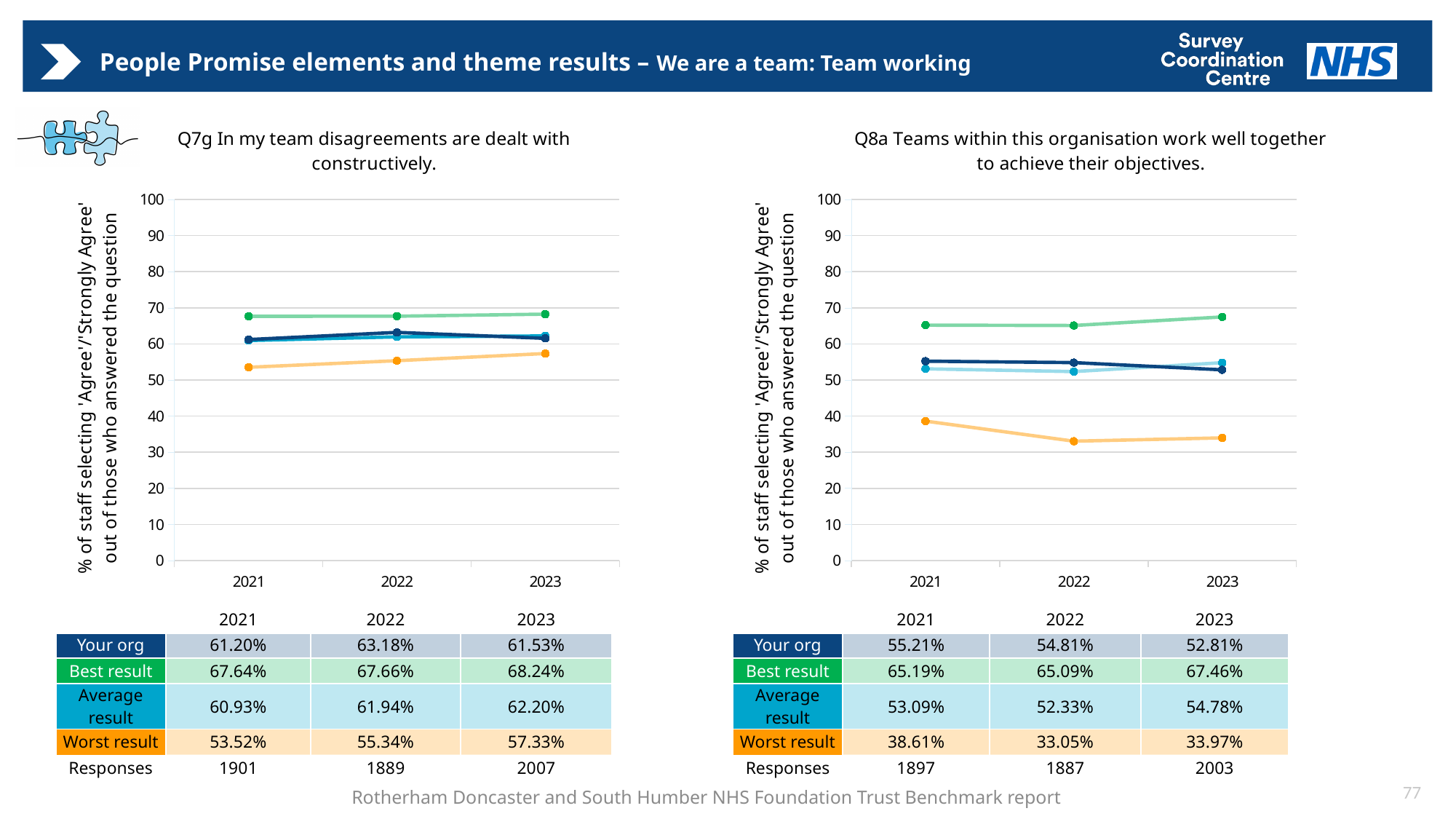
In the Q7g chart, in which year was the Best result highest? 2023 In the Q8a chart, what was the Worst result value in 2021? 38.61% How many lines are plotted in the Q8a chart? 4 In the Q7g chart, does the Worst result line rise or fall from 2021 to 2023? Rises In the Q8a table, how many responses were there in 2023? 2003 How many years are shown on the x axis of the Q7g chart? 3 In the Q7g chart, what was the Your org value in 2022? 63.18% In the Q8a chart, which was larger in 2023: Your org or Average result? Average result What type of chart is used for Q7g? Line chart In the Q7g chart, what is the difference between the Best result and the Worst result in 2023? 10.91 percentage points In the Q8a chart, in which year was the Your org value lowest? 2023 In the Q8a chart, is the Best result value for 2023 greater or less than 60? greater